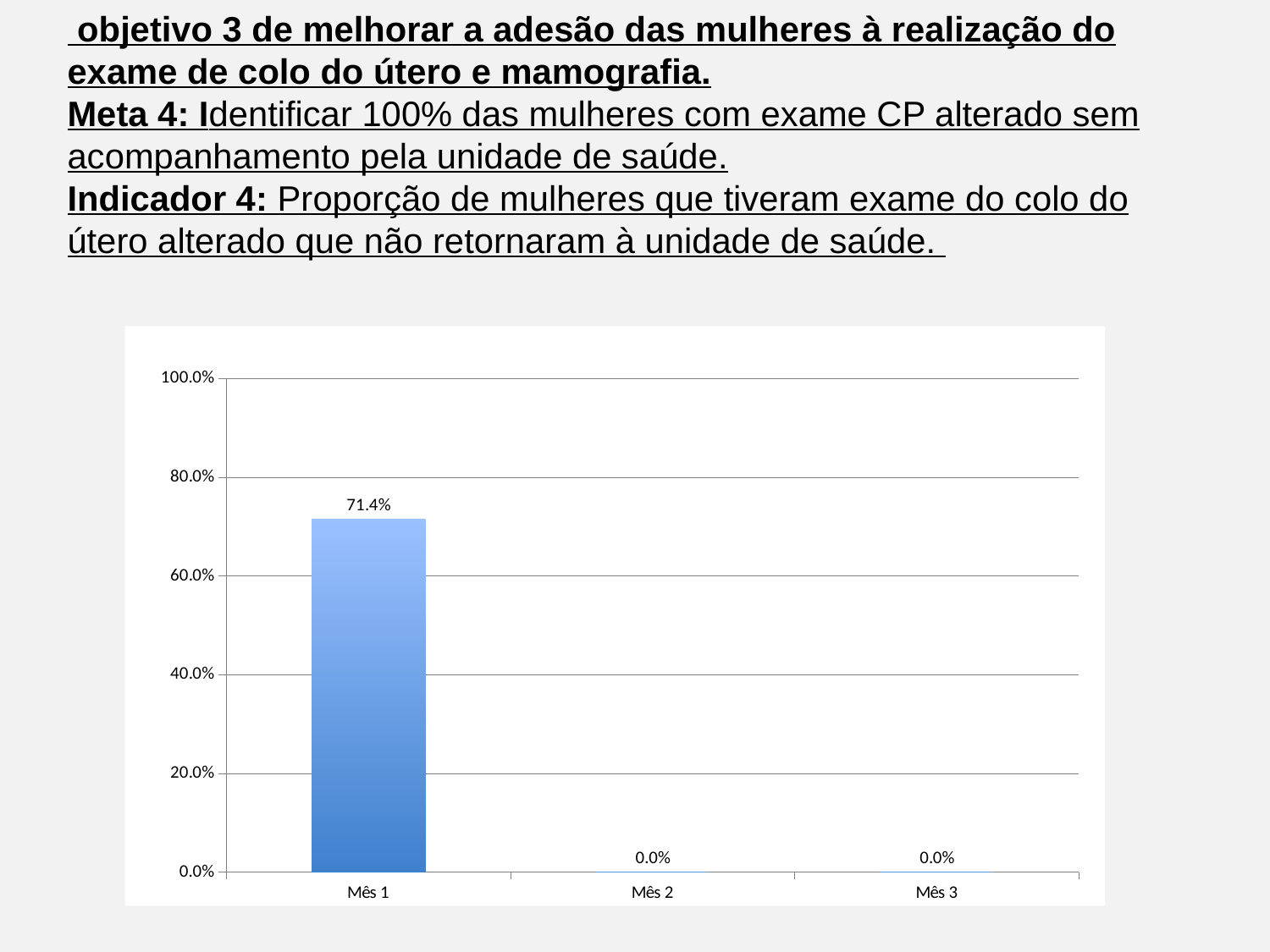
Is the value for Mês 1 greater or less than 80.0%? less Do the values rise or fall from Mês 1 to Mês 3? fall Which month has the highest value? Mês 1 What is the difference between the values for Mês 1 and Mês 2? 71.4% How many categories are shown on the x axis? 3 Is the value for Mês 1 greater or less than 60.0%? greater Which is larger, the value for Mês 1 or the value for Mês 3? Mês 1 What is the value for Mês 2? 0.0% What is the value for Mês 1? 71.4% What is the value for Mês 3? 0.0% What is the highest value shown on the y axis? 100.0% What kind of chart is shown on the slide? bar chart